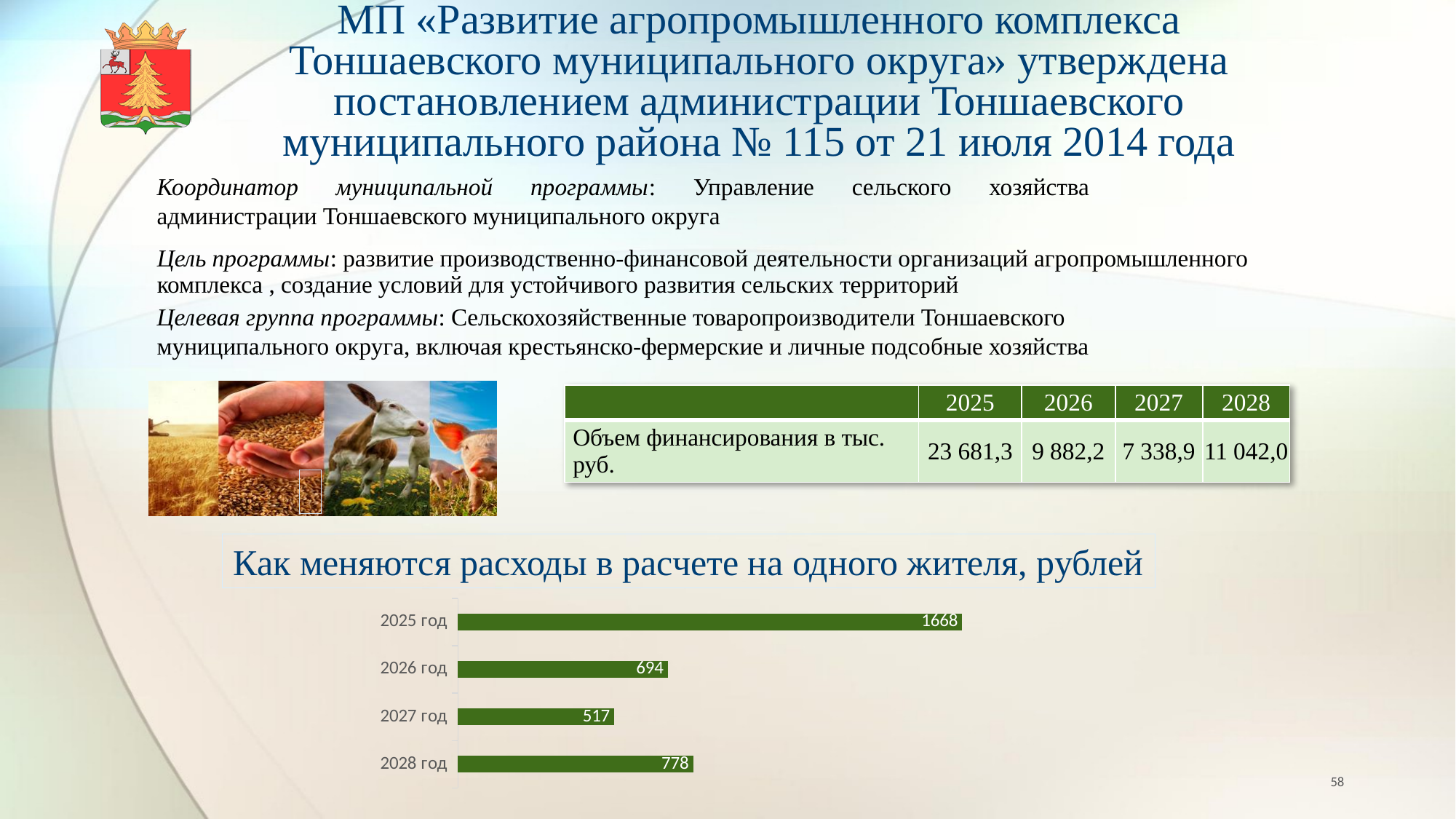
How many years are shown in the chart? 4 What is the value for 2027 год in the chart? 517 What is the value for 2028 год in the chart? 778 What is the value for 2025 год in the chart? 1668 What kind of chart is shown on the slide? bar chart What is the value for 2026 год in the chart? 694 What is the title of the chart? Как меняются расходы в расчете на одного жителя, рублей Which is larger, the value for 2026 год or the value for 2028 год? 2028 год What is the difference between the values for 2028 год and 2027 год? 261 Which year has the lowest value in the chart? 2027 год What is the difference between the values for 2025 год and 2026 год? 974 Which year has the highest value in the chart? 2025 год